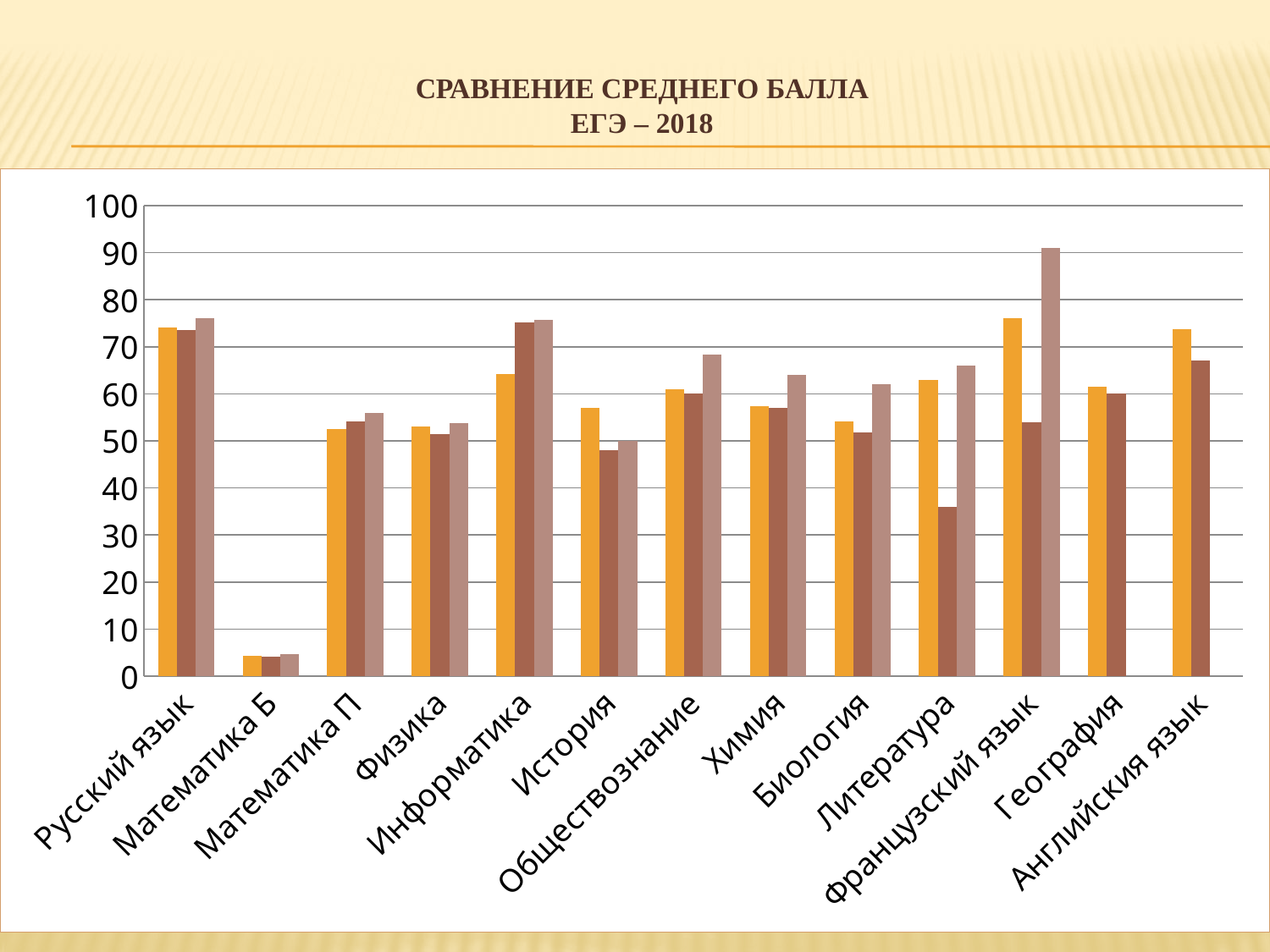
What kind of chart is shown on the slide? bar chart Is the orange bar for Математика Б greater or less than 10? less What is the title of the slide? СРАВНЕНИЕ СРЕДНЕГО БАЛЛА ЕГЭ – 2018 For Французский язык, which is larger: the orange bar or the dark brown bar? the orange bar Is the dark brown bar for Литература greater or less than 40? less Which subject contains the tallest single bar in the chart? Французский язык Is the light brown bar for Французский язык greater or less than 80? greater How many subject categories are shown on the x axis? 13 Which subject has the lowest bars in the chart? Математика Б For История, which is larger: the orange bar or the dark brown bar? the orange bar